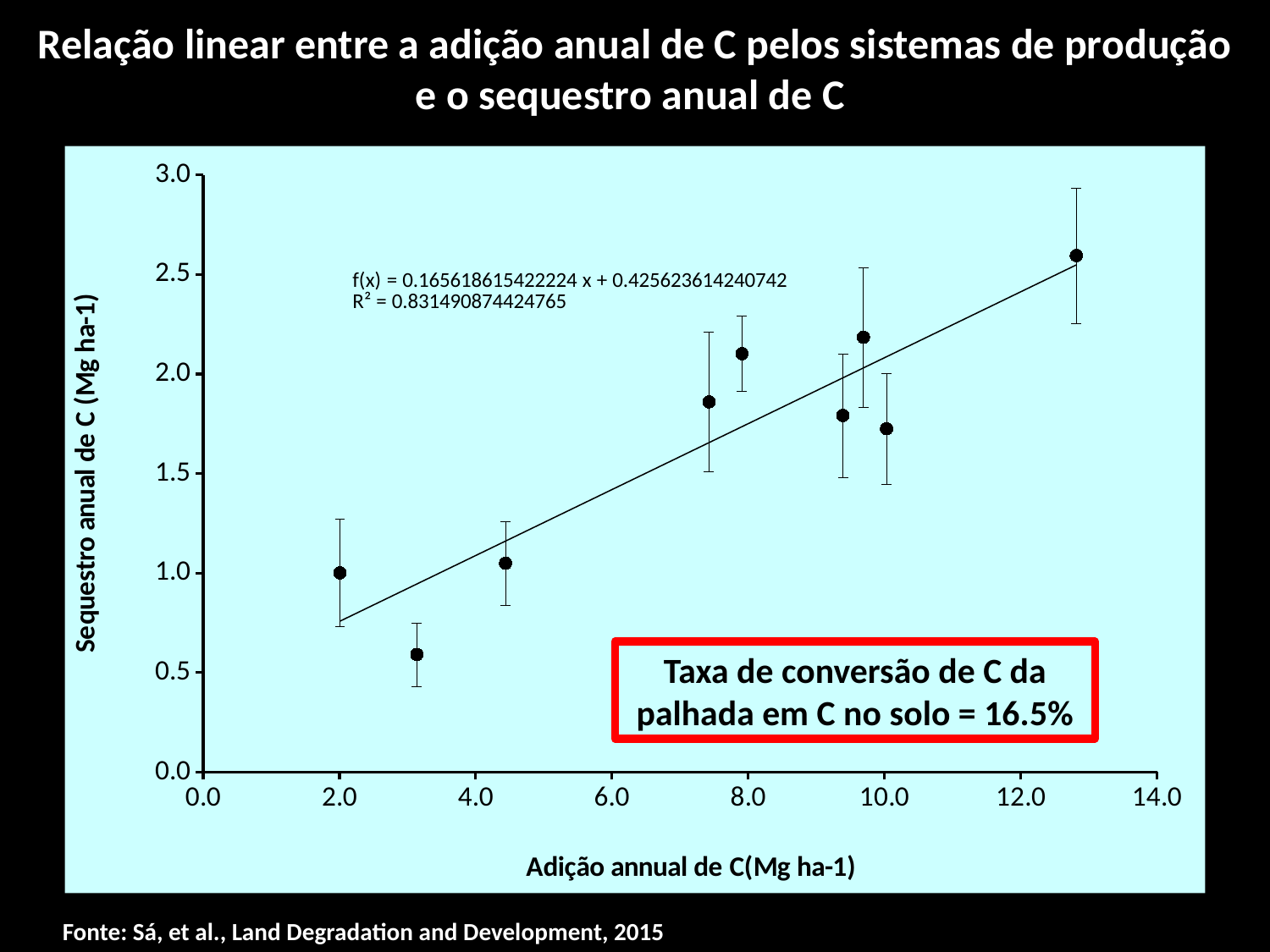
What kind of chart is shown on the slide? Scatter plot Is the y value of the data point at about 2.0 on the x axis greater or less than 1.5? less How many data points are plotted on the chart? 9 Is the y value of the rightmost data point (near 12.8 on the x axis) greater or less than 2.0? greater Is the y value of the lowest data point (near 3.0 on the x axis) greater or less than 1.0? less What is the maximum value shown on the x axis? 14.0 What is the R² value shown on the chart? 0.831490874424765 Do the values of annual C sequestration generally rise or fall as annual C addition increases along the x axis? Rise What conversion rate of straw C to soil C is stated in the red box on the chart? 16.5% Which data point has the highest y value: the one near 12.8 on the x axis or the one near 3.0 on the x axis? The one near 12.8